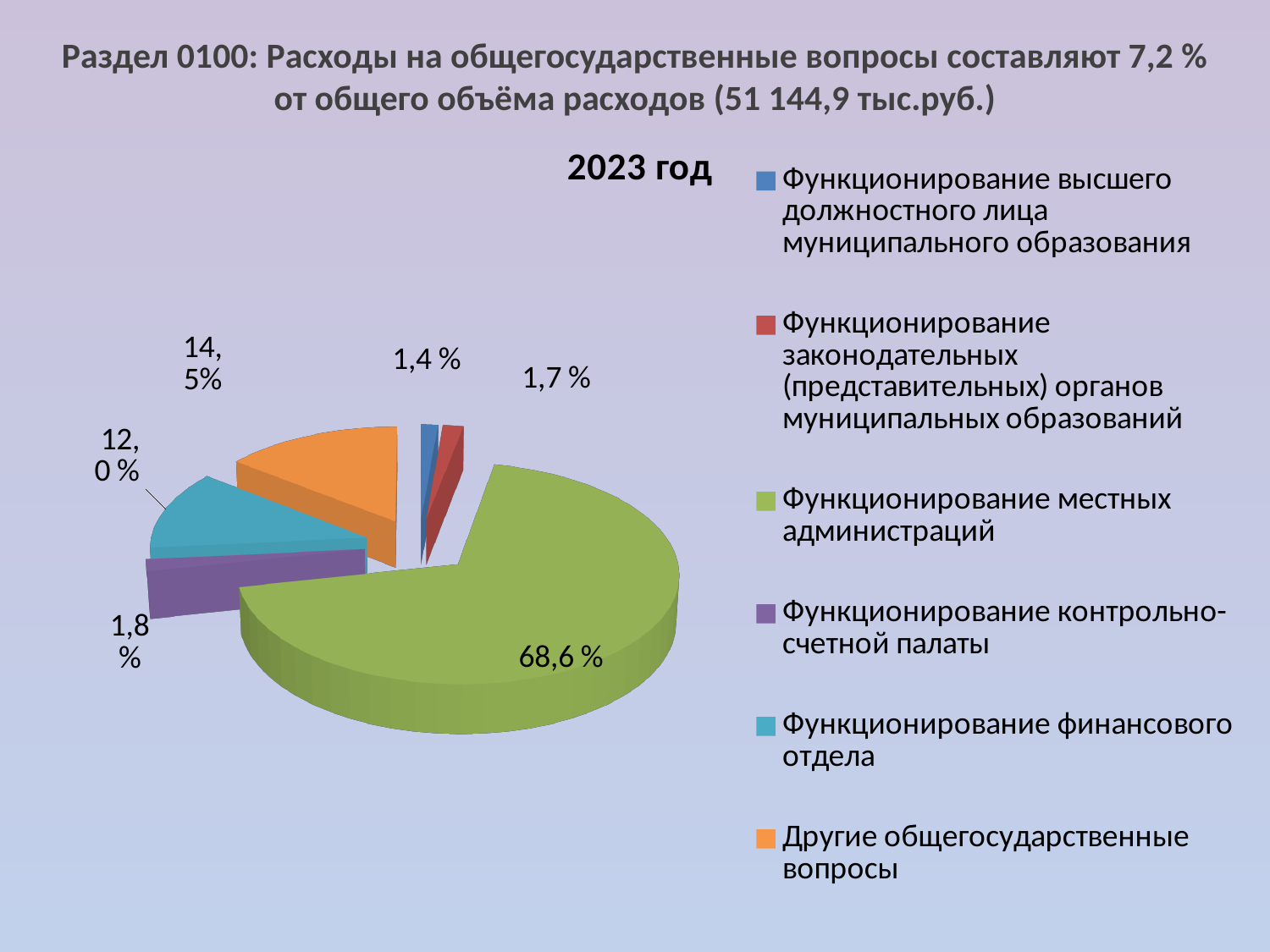
What share of the pie is 'Функционирование местных администраций'? 68,6 % How many entries does the legend list? 6 What share of the pie is 'Функционирование высшего должностного лица муниципального образования'? 1,4 % What share of the pie is 'Другие общегосударственные вопросы'? 14,5% How many slices does the pie chart have? 6 Which category has the smallest share of the pie? Функционирование высшего должностного лица муниципального образования What is the chart's title? 2023 год What kind of chart is shown on the slide? pie chart What is the difference between the shares of 'Другие общегосударственные вопросы' and 'Функционирование финансового отдела'? 2,5 % Which category has the largest share of the pie? Функционирование местных администраций Which is larger: the share of 'Функционирование контрольно-счетной палаты' or 'Функционирование законодательных (представительных) органов муниципальных образований'? Функционирование контрольно-счетной палаты What share of the pie is 'Функционирование финансового отдела'? 12,0 %